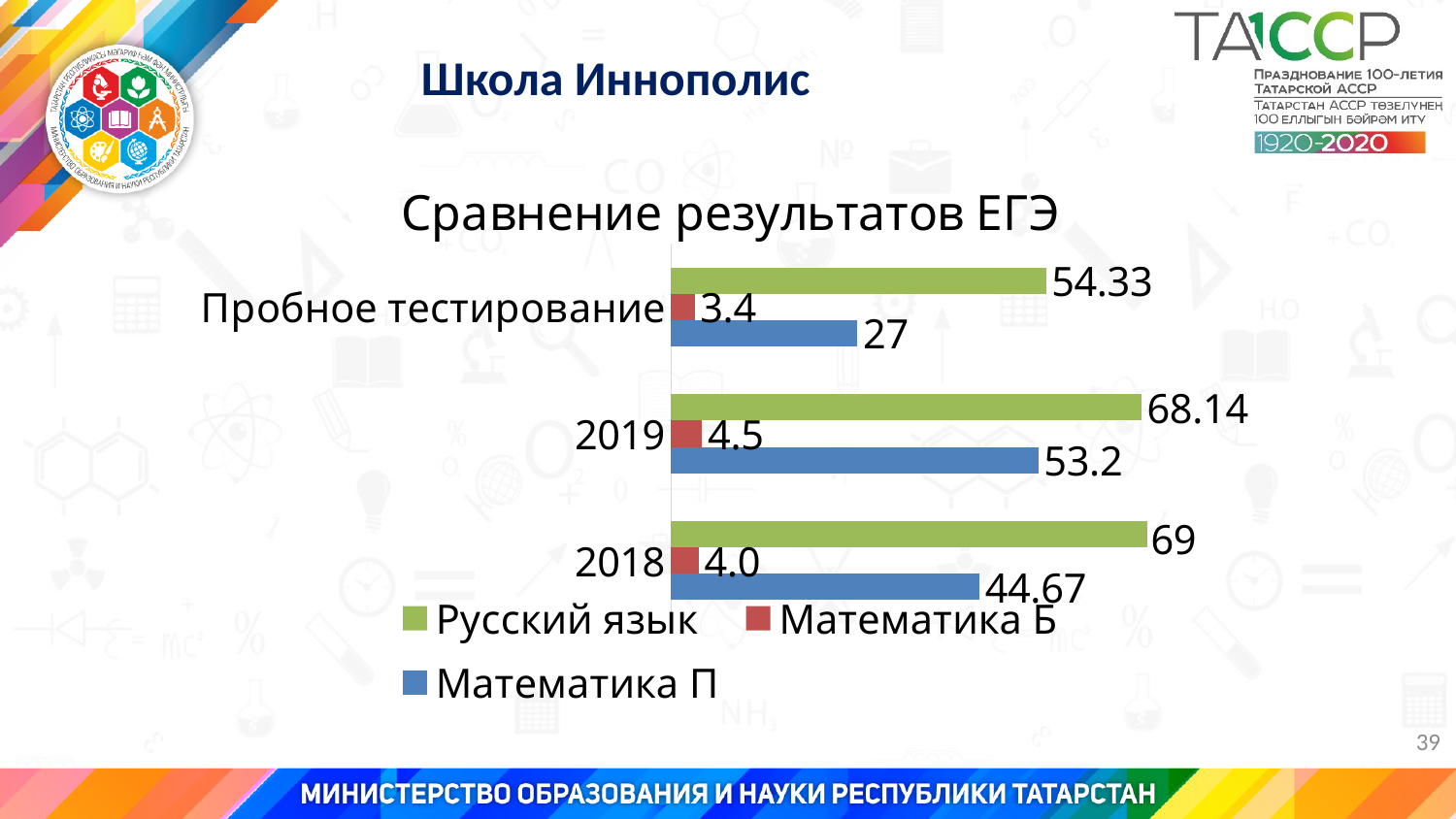
Which category has the lowest value for Математика П? Пробное тестирование What is the value for Русский язык in 2019? 68.14 What is the value for Математика Б in 2018? 4.0 What kind of chart is shown on the slide? bar chart Which category has the highest value for Русский язык? 2018 What is the title of the chart? Сравнение результатов ЕГЭ How many categories are shown on the chart? 3 How many series does the legend list? 3 What is the value for Математика П for Пробное тестирование? 27 What is the difference between the Русский язык values for 2018 and 2019? 0.86 What is the value for Математика П in 2019? 53.2 Which is larger: Математика П in 2019 or Математика П in 2018? 2019